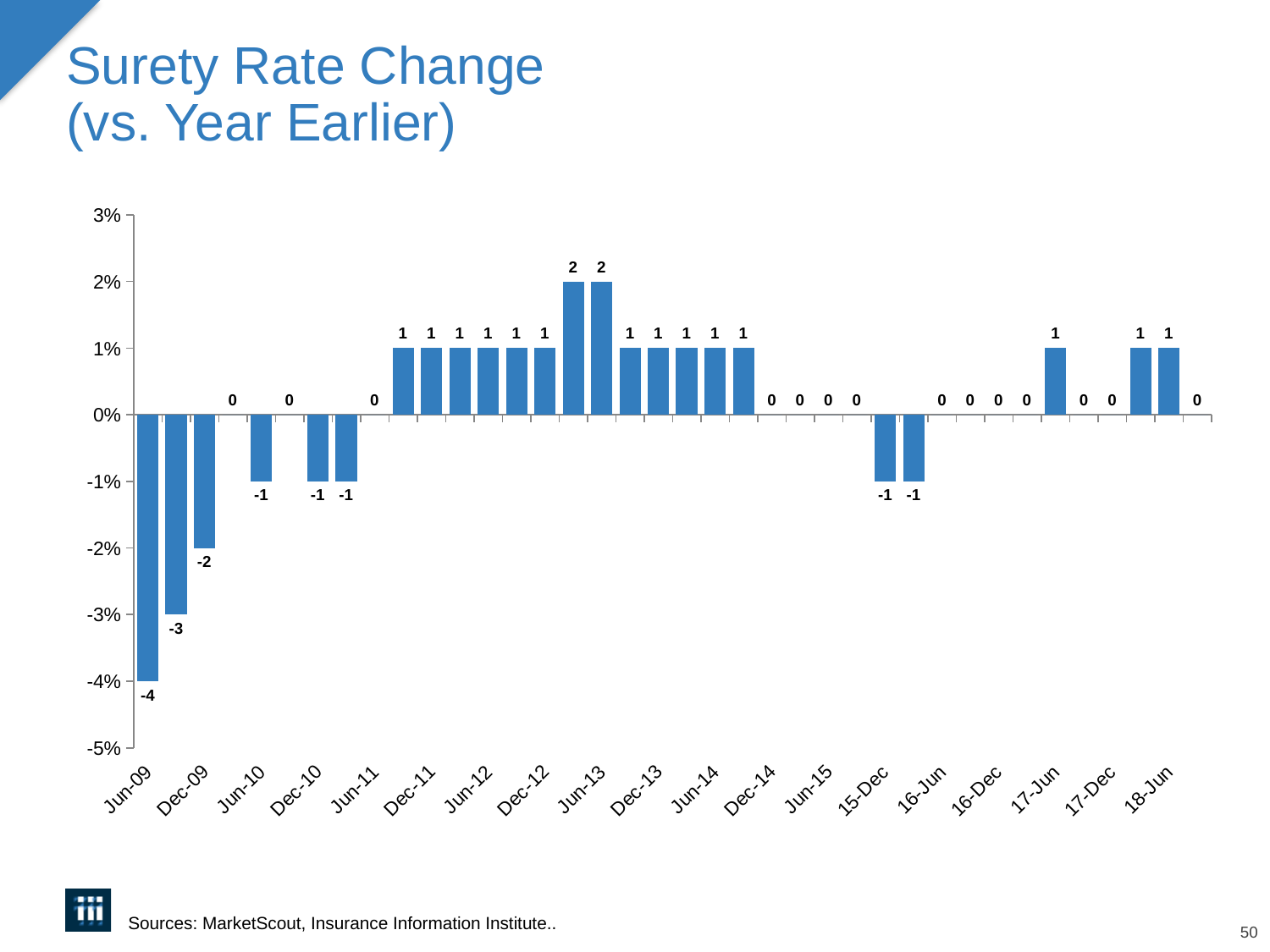
What is the title of the chart? Surety Rate Change (vs. Year Earlier) Is the value for Jun-09 greater or less than -3%? less How many bars have a value of 2? 2 Which is larger, the first bar (-4) or the second bar (-3)? the second bar (-3) What type of chart is shown on the slide? bar chart What is the lowest value shown in the chart? -4 What is the value of the first bar (Jun-09)? -4 What is the highest value shown in the chart? 2 Do the values rise or fall from Jun-09 through the bars labeled 2? rise Which period has the lowest surety rate change? Jun-09 How many period labels are shown on the x axis? 19 What is the difference between the highest value (2) and the lowest value (-4) in the chart? 6